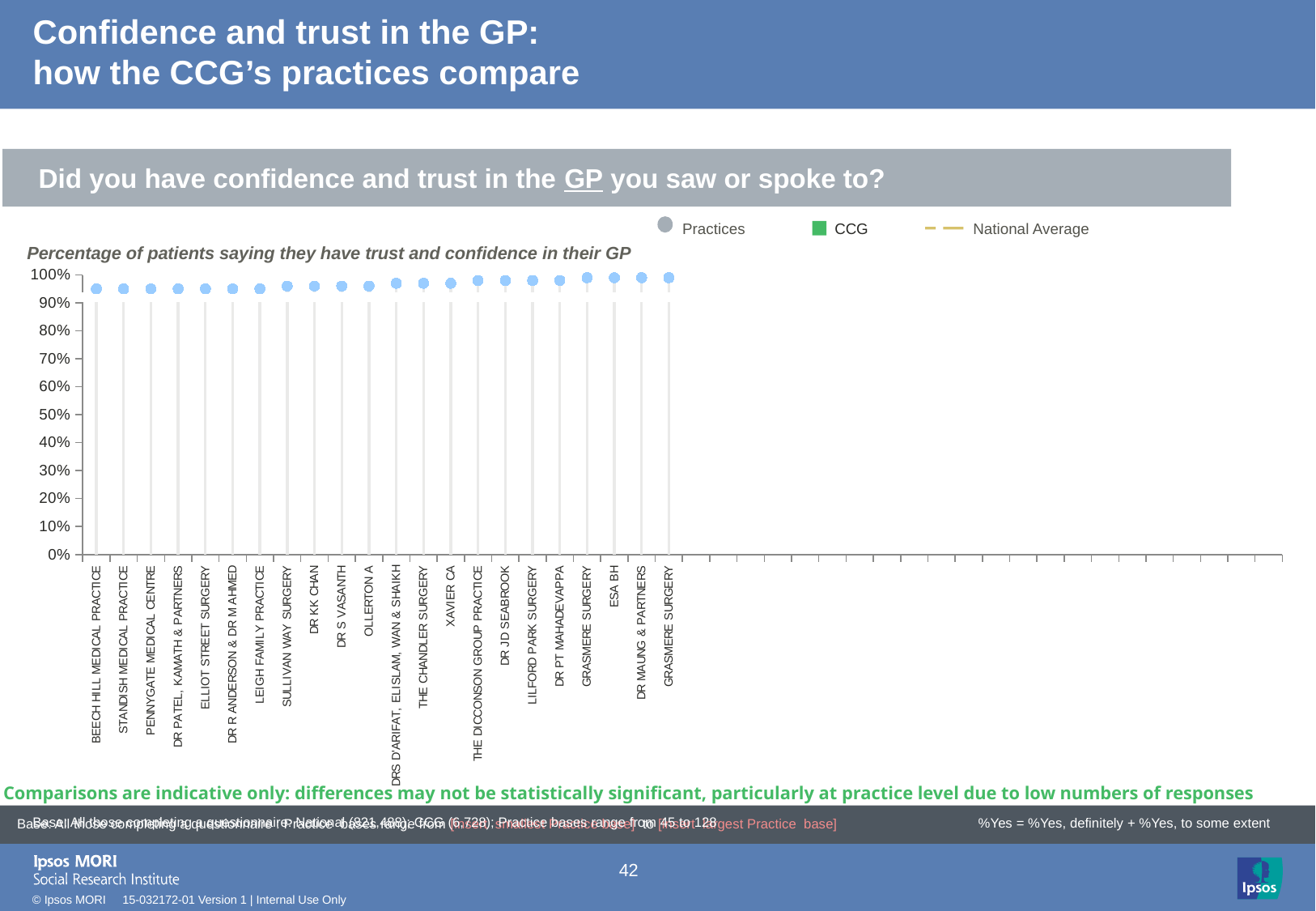
Which has the higher value, BEECH HILL MEDICAL PRACTICE or DR MAUNG & PARTNERS? DR MAUNG & PARTNERS Is the value for DR KK CHAN greater or less than 80%? greater Is the value for DR MAUNG & PARTNERS greater or less than 90%? greater What is the highest value shown on the y axis? 100% How many entries does the chart legend list? 3 What are the three entries in the chart legend? Practices, CCG, National Average Which has the higher value, STANDISH MEDICAL PRACTICE or ESA BH? ESA BH How many practices are plotted on the chart? 22 What is the label of the first practice on the left of the x axis? BEECH HILL MEDICAL PRACTICE Is the value for LEIGH FAMILY PRACTICE greater or less than 100%? less Do the plotted values rise or fall moving from left to right along the x axis? rise